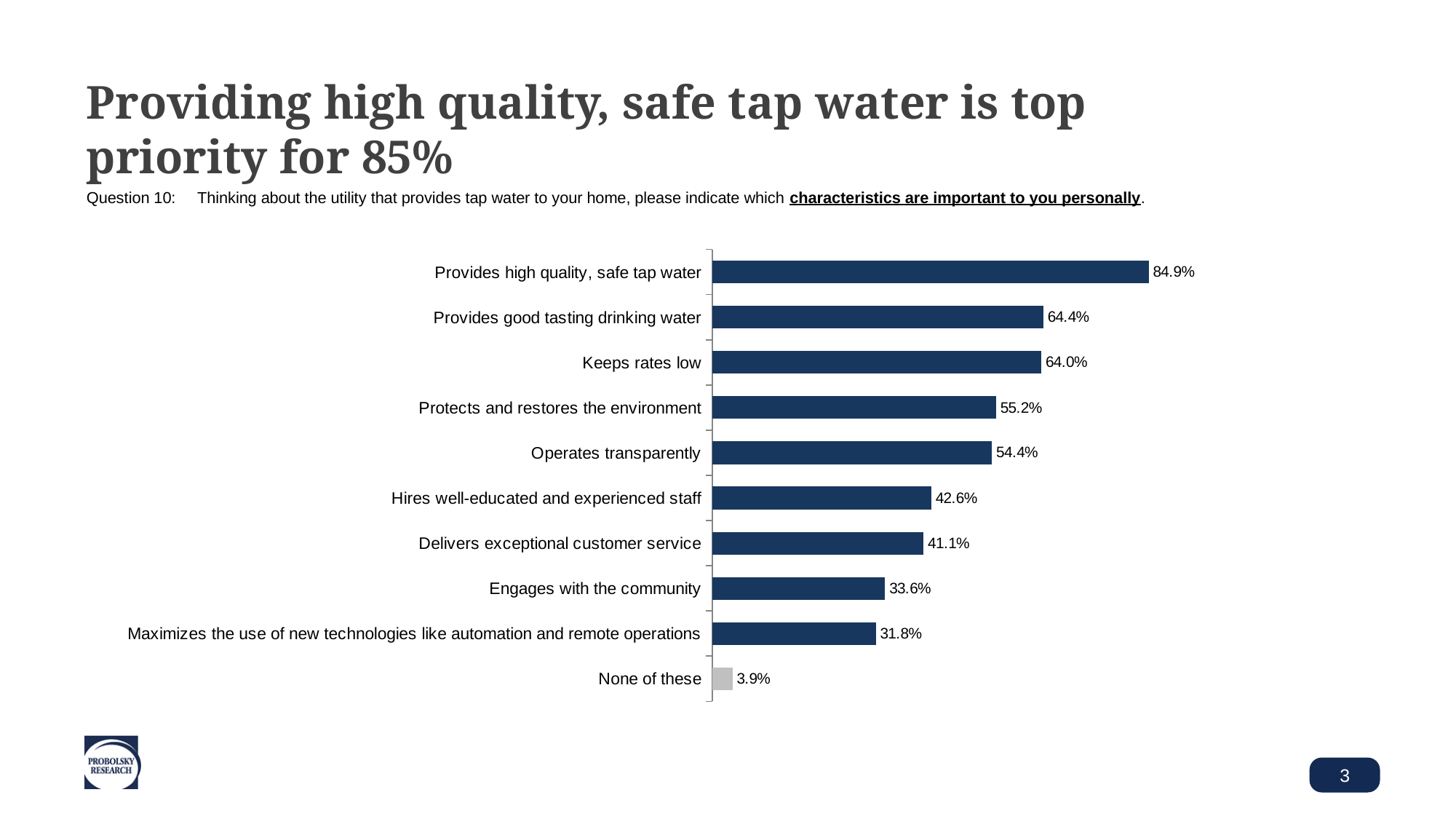
Which is larger: 'Protects and restores the environment' or 'Operates transparently'? Protects and restores the environment How many categories are shown in the chart? 10 Which characteristic has the highest percentage? Provides high quality, safe tap water What percentage of respondents said 'Provides high quality, safe tap water' is important to them? 84.9% What percentage is shown for 'Engages with the community'? 33.6% What is the value for 'None of these'? 3.9% What is the value shown for 'Keeps rates low'? 64.0% Which bar is shown in a different colour (grey) from the others? None of these What is the difference between 'Hires well-educated and experienced staff' and 'Delivers exceptional customer service'? 1.5 What is the difference in percentage points between 'Provides high quality, safe tap water' and 'Provides good tasting drinking water'? 20.5 Which category has the lowest percentage? None of these What type of chart is shown on the slide? Bar chart